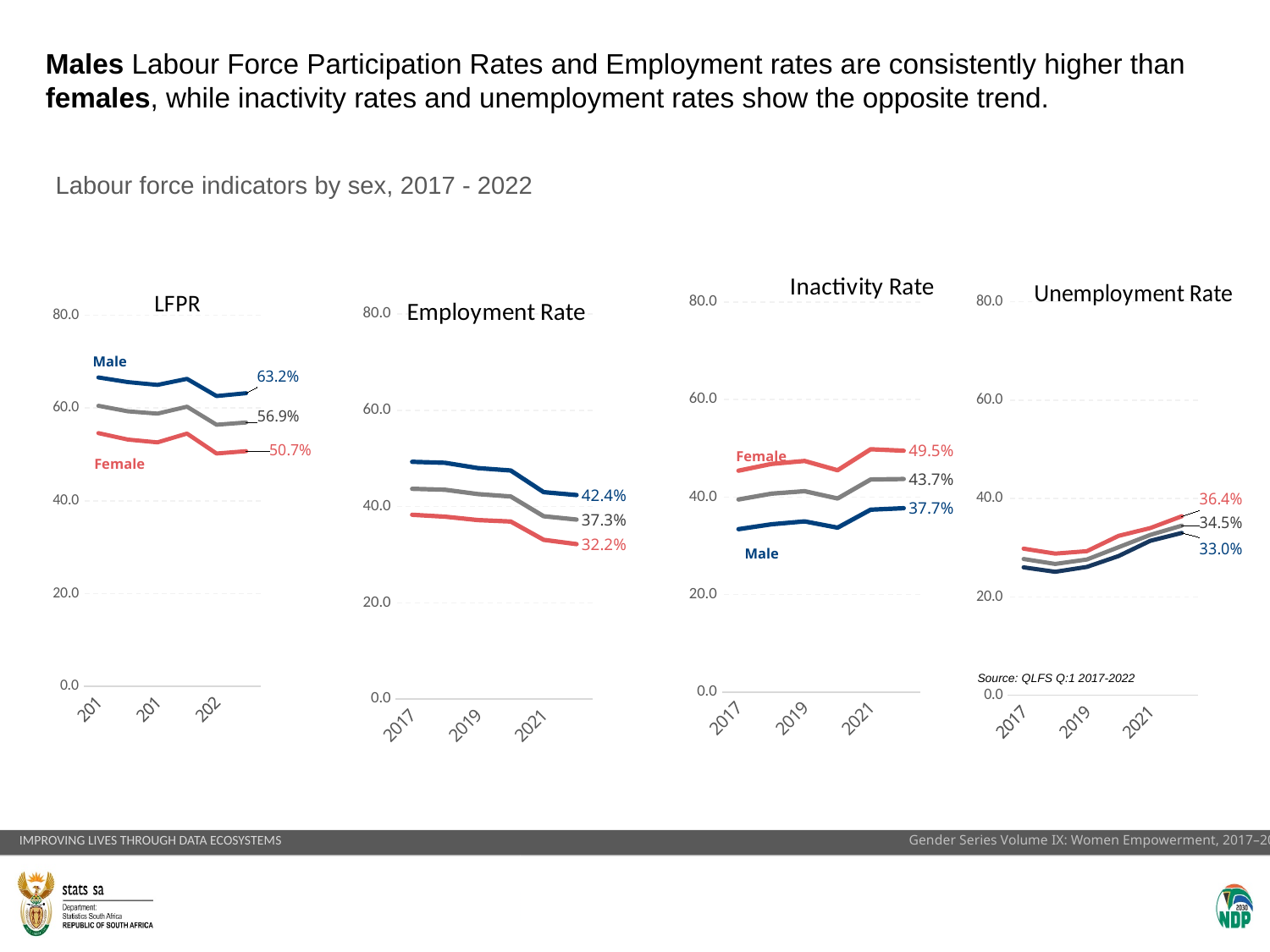
In the Inactivity Rate chart, what is the difference between the final Female value (49.5%) and the final Male value (37.7%)? 11.8 percentage points What kind of chart is used for the four labour force indicators on the slide? line chart In the LFPR chart, is the Male line greater or less than 60.0 throughout the period? greater In the Unemployment Rate chart, what is the lowest value labelled at the end of the lines? 33.0% In the Inactivity Rate chart, what is the value labelled at the end of the Male line? 37.7% In the Inactivity Rate chart, what is the value labelled at the end of the Female line? 49.5% In the Employment Rate chart, do the lines generally rise or fall from 2017 to 2022? fall In the Inactivity Rate chart, which line ends higher, Female or Male? Female In the Employment Rate chart, what is the highest value labelled at the end of the lines? 42.4% In the LFPR chart, what is the value labelled at the end of the Male line? 63.2% In the LFPR chart, what is the value labelled at the end of the Female line? 50.7% In the LFPR chart, what is the difference between the final Male value (63.2%) and the final Female value (50.7%)? 12.5 percentage points